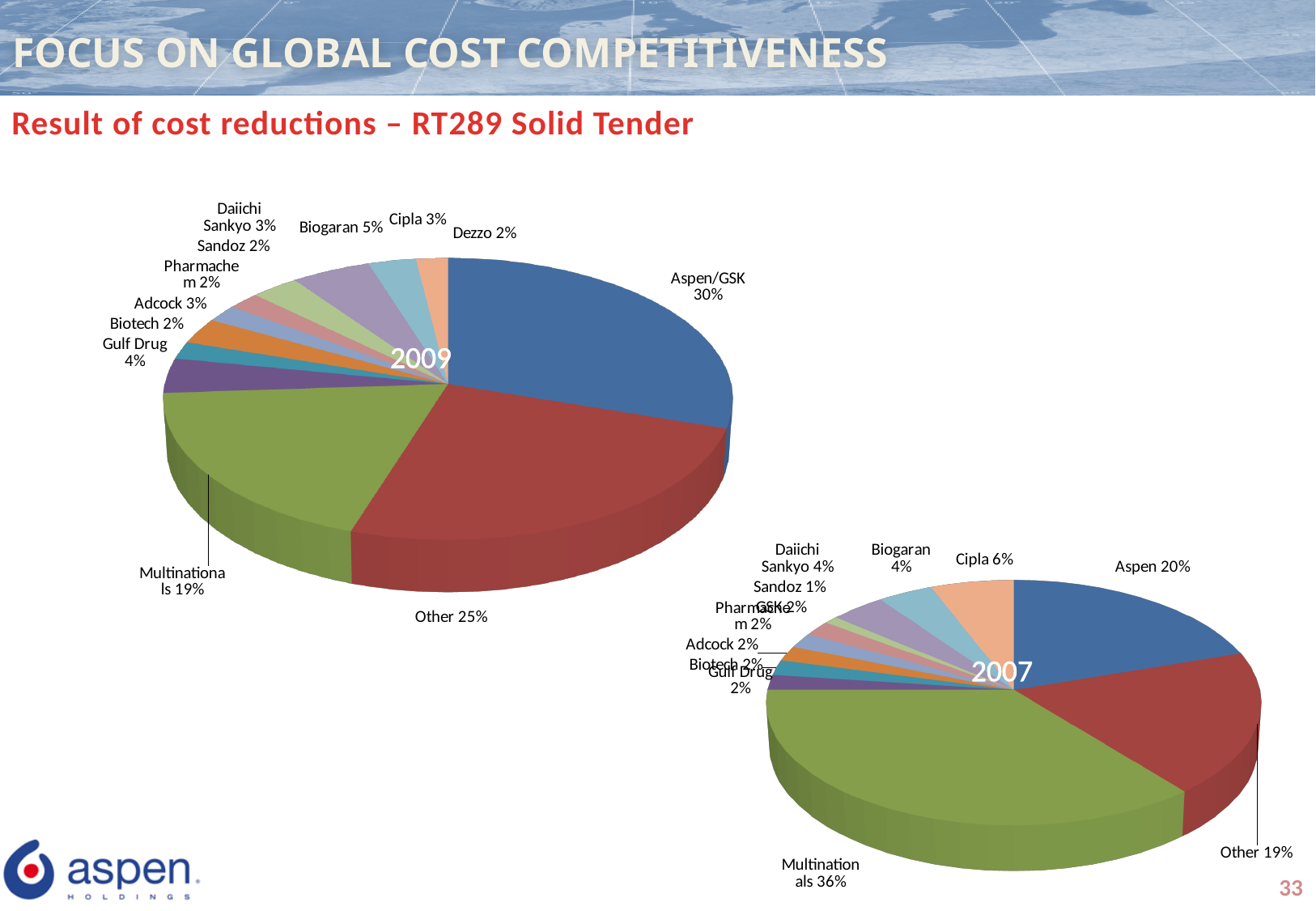
How many categories are shown in the 2009 pie chart? 12 In the 2007 pie chart, what is the share for Cipla? 6% In the 2007 pie chart, what share do Multinationals hold? 36% In the 2009 pie chart, what share does Aspen/GSK hold? 30% In the 2007 pie chart, what is the difference in percentage points between Multinationals and Aspen? 16 In the 2007 pie chart, which category has the largest share? Multinationals Which is larger in the 2009 pie chart: the share for Gulf Drug or the share for Adcock? Gulf Drug In the 2007 pie chart, which category has the smallest share? Sandoz In the 2009 pie chart, what is the difference in percentage points between Aspen/GSK and Other? 5 What type of chart is used to show the 2007 data? Pie chart In the 2009 pie chart, what is the share for Biogaran? 5% In the 2009 pie chart, which category has the largest share? Aspen/GSK